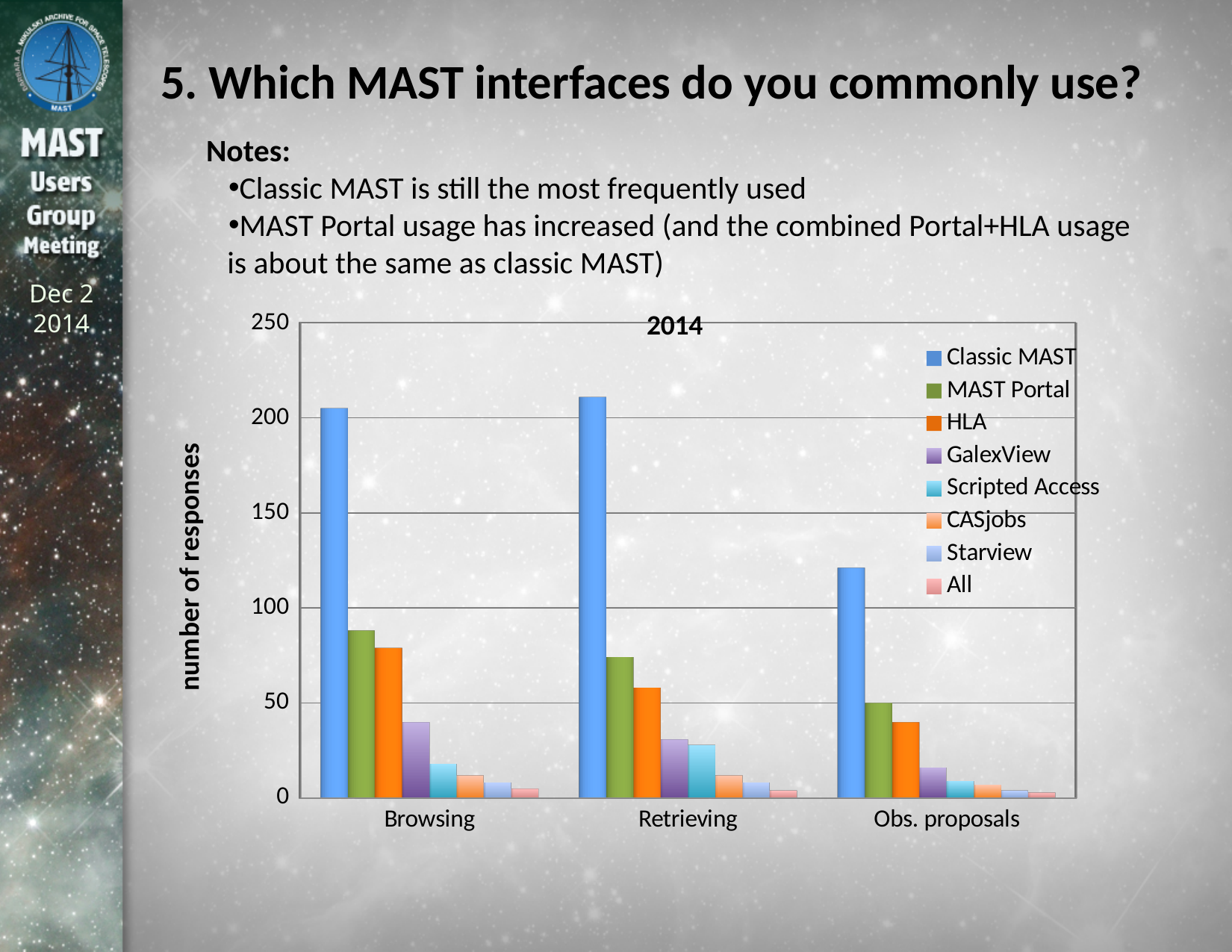
Is the Classic MAST value for Obs. proposals greater or less than 150? less Do the HLA values rise or fall from Browsing to Retrieving to Obs. proposals? fall Which is larger for Classic MAST: the Browsing value or the Obs. proposals value? Browsing What is the label on the vertical axis of the chart? number of responses What kind of chart is shown on the slide? bar chart How many series does the chart legend list? 8 Is the HLA value for Retrieving greater or less than 50? greater Which series has the lowest value in the Obs. proposals category? All Is the Classic MAST value for Browsing greater or less than 200? greater How many categories are shown on the x axis of the chart? 3 Which series has the highest value in the Browsing category? Classic MAST